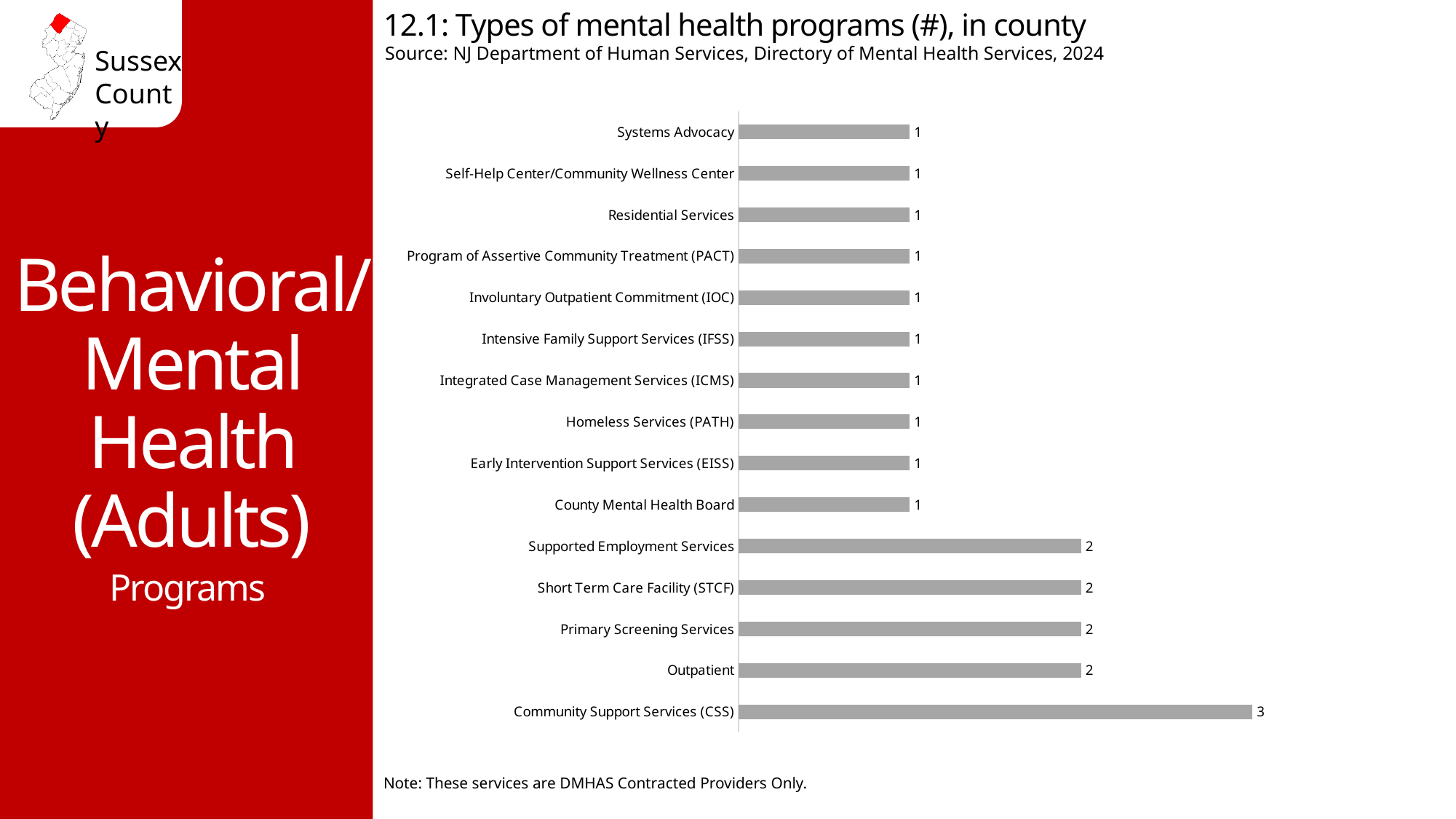
How many types of mental health programs are shown in the chart? 15 What is the difference between Short Term Care Facility (STCF) and Residential Services? 1 How many programs are there for Community Support Services (CSS)? 3 What is the title of the chart? 12.1: Types of mental health programs (#), in county Which is larger, Outpatient or Systems Advocacy? Outpatient What kind of chart is shown on the slide? Bar chart Which is larger, County Mental Health Board or Community Support Services (CSS)? Community Support Services (CSS) Which type of mental health program has the highest number? Community Support Services (CSS) What is the value for Outpatient? 2 What is the value for Homeless Services (PATH)? 1 What is the difference between Community Support Services (CSS) and Primary Screening Services? 1 What is the value for Supported Employment Services? 2